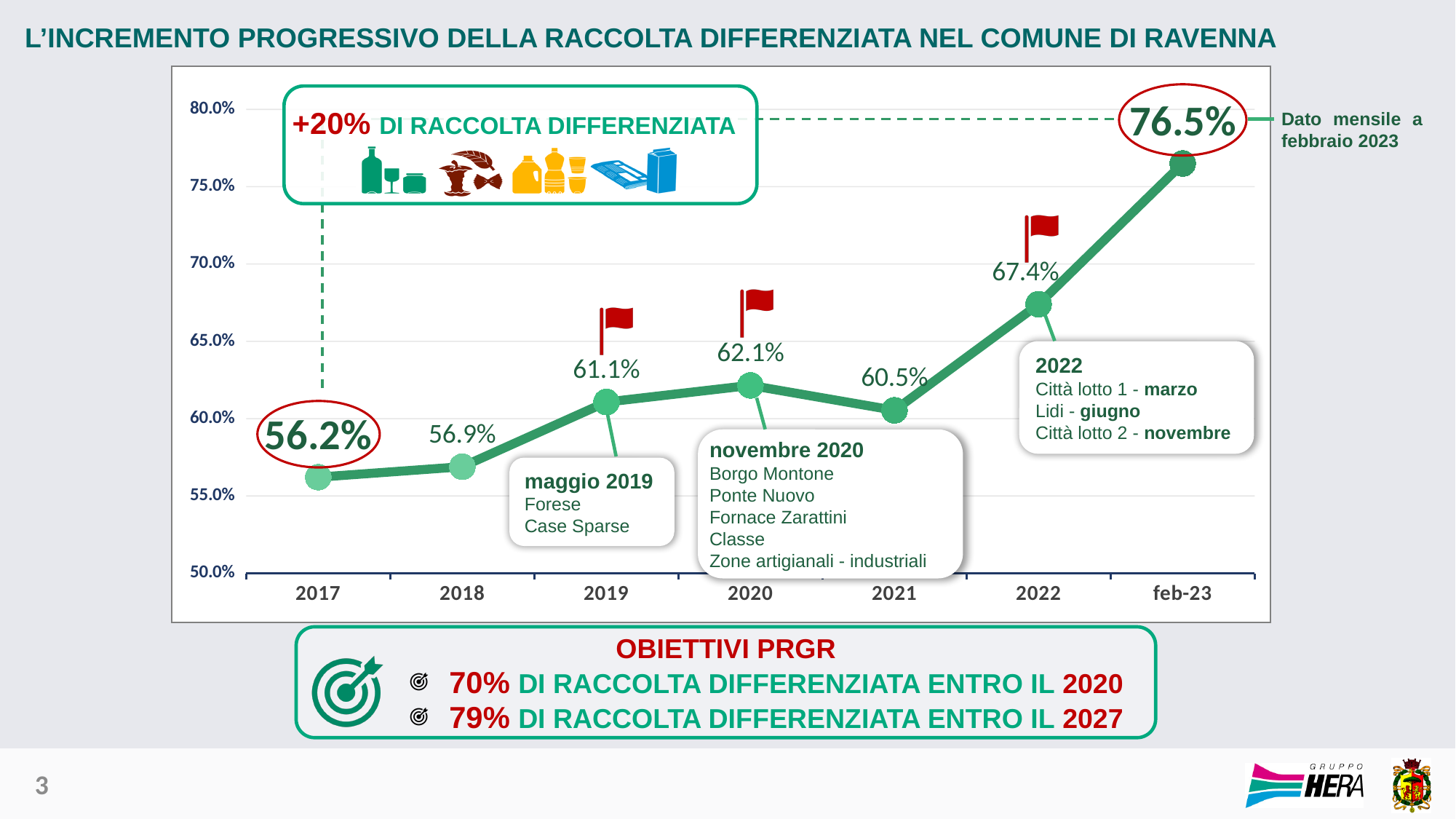
How many data points are plotted on the line? 7 What is the value for 2019? 61.1% What is the value for feb-23? 76.5% Which point on the x axis has the highest value? feb-23 What kind of chart is shown on the slide? line chart What is the difference between the values for 2020 and 2021? 1.6% What is the value for 2017? 56.2% Which is larger, the value for 2020 or the value for 2021? 2020 Which point on the x axis has the lowest value? 2017 What is the difference between the values for feb-23 and 2022? 9.1% What is the value for 2021? 60.5% Is the value for 2022 greater or less than 65.0%? greater